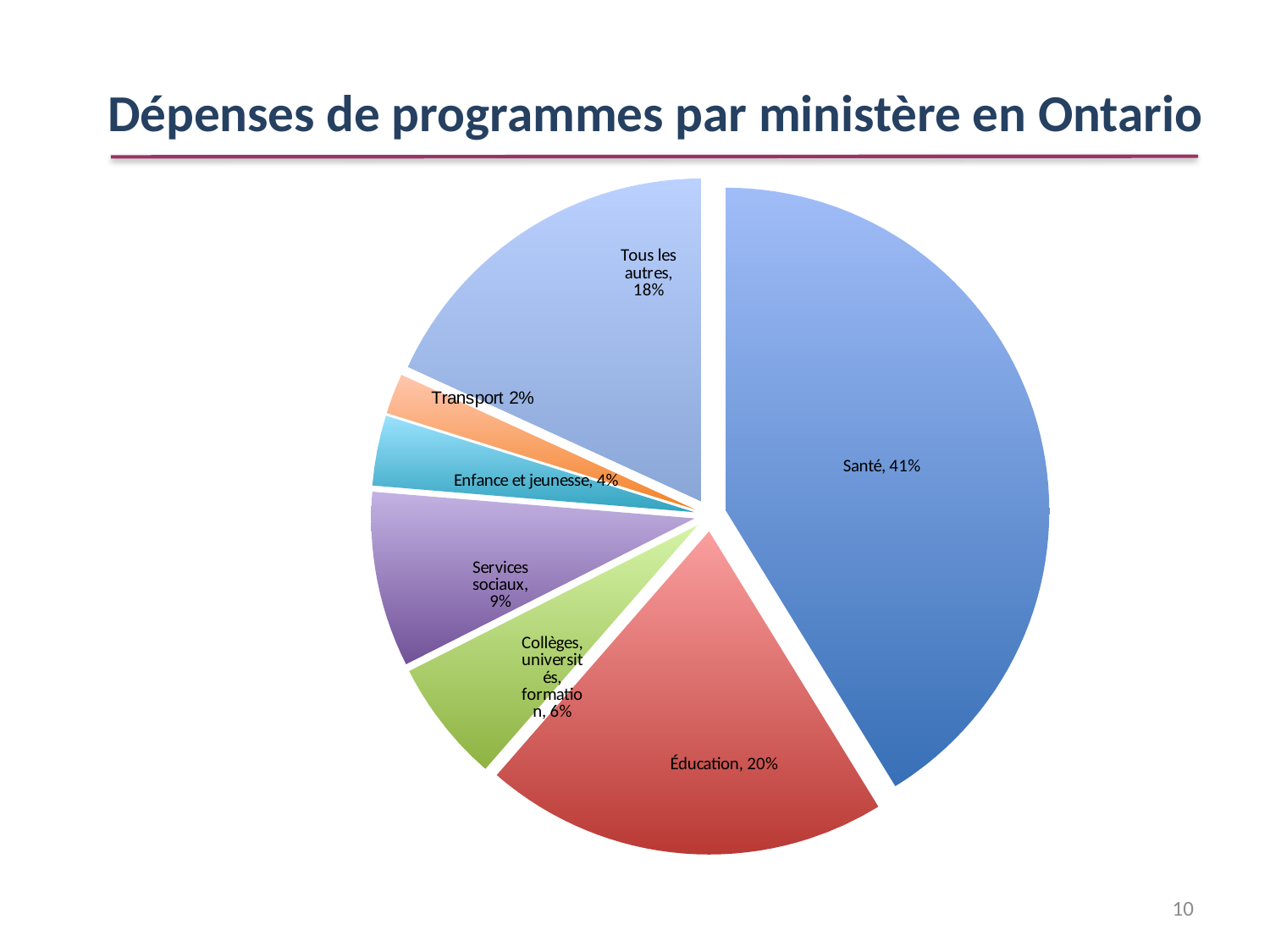
Which category has the smallest slice of the pie? Transport Which is larger, the share for Tous les autres or the share for Services sociaux? Tous les autres What is the difference in percentage points between Santé and Éducation? 21 What percentage is shown for Services sociaux? 9% What share of program spending goes to Santé? 41% What is the title of the slide? Dépenses de programmes par ministère en Ontario What percentage is shown for Transport? 2% What percentage is shown for Enfance et jeunesse? 4% What kind of chart is shown on the slide? pie chart Which category has the largest slice of the pie? Santé How many slices does the pie chart have? 7 What percentage is shown for Éducation? 20%